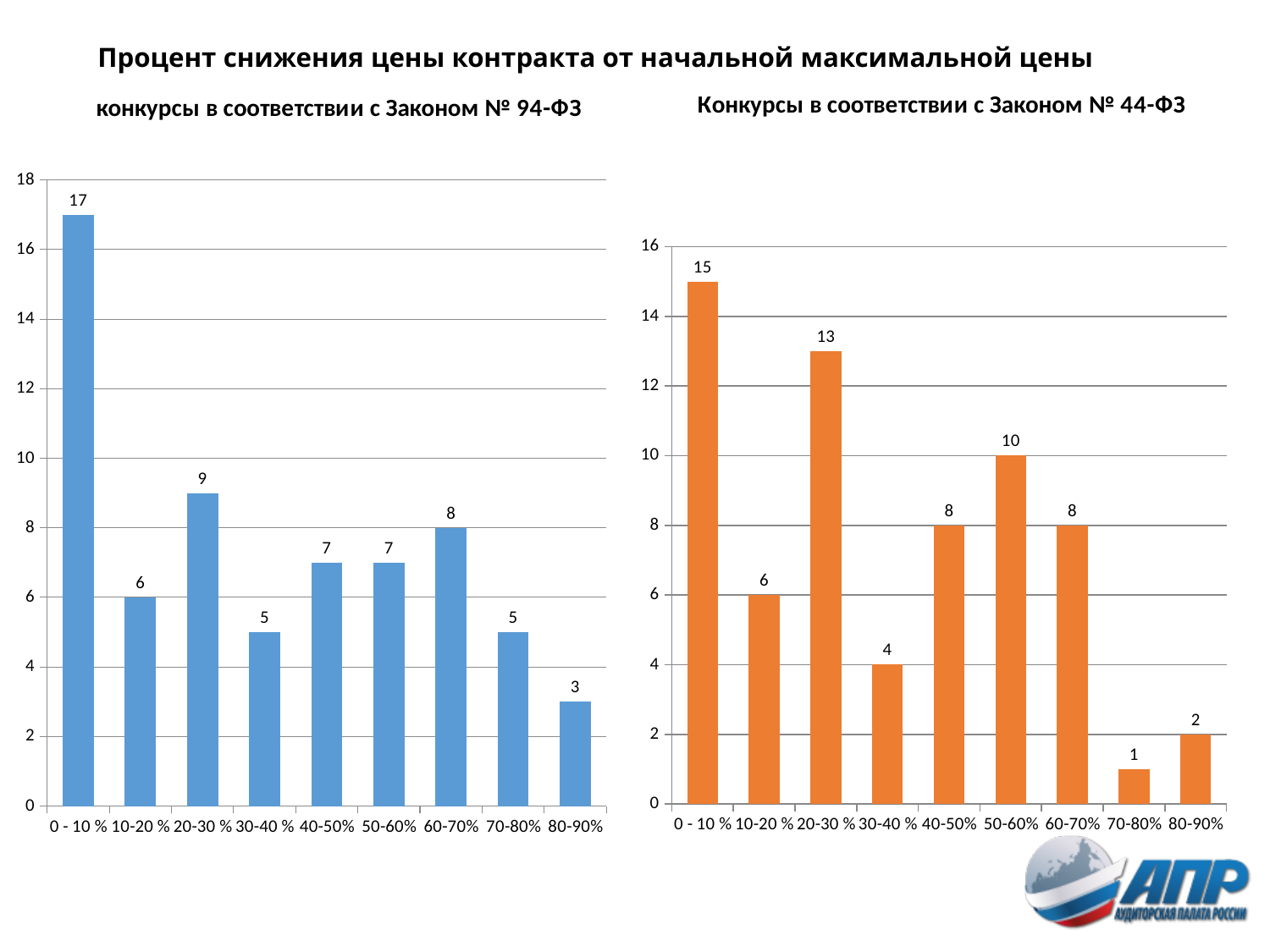
In the right chart (Закон № 44-ФЗ), which is larger: the value for 50-60% or the value for 60-70%? 50-60% In the right chart (Закон № 44-ФЗ), which category has the lowest value? 70-80% How many categories are shown on the x axis of the right chart (Закон № 44-ФЗ)? 9 In the left chart (Закон № 94-ФЗ), what is the difference between the values for 0 - 10 % and 80-90%? 14 In the right chart (Закон № 44-ФЗ), what is the difference between the values for 0 - 10 % and 10-20 %? 9 In the left chart (конкурсы в соответствии с Законом № 94-ФЗ), what is the value for the 0 - 10 % category? 17 What kind of chart is the left chart (Закон № 94-ФЗ)? Bar chart In the left chart (Закон № 94-ФЗ), is the value for 20-30 % greater or less than 8? greater What is the main title at the top of the slide? Процент снижения цены контракта от начальной максимальной цены What colour are the bars in the right chart (Закон № 44-ФЗ)? Orange In the right chart (Конкурсы в соответствии с Законом № 44-ФЗ), what is the value for the 20-30 % category? 13 In the left chart (Закон № 94-ФЗ), which category has the highest value? 0 - 10 %